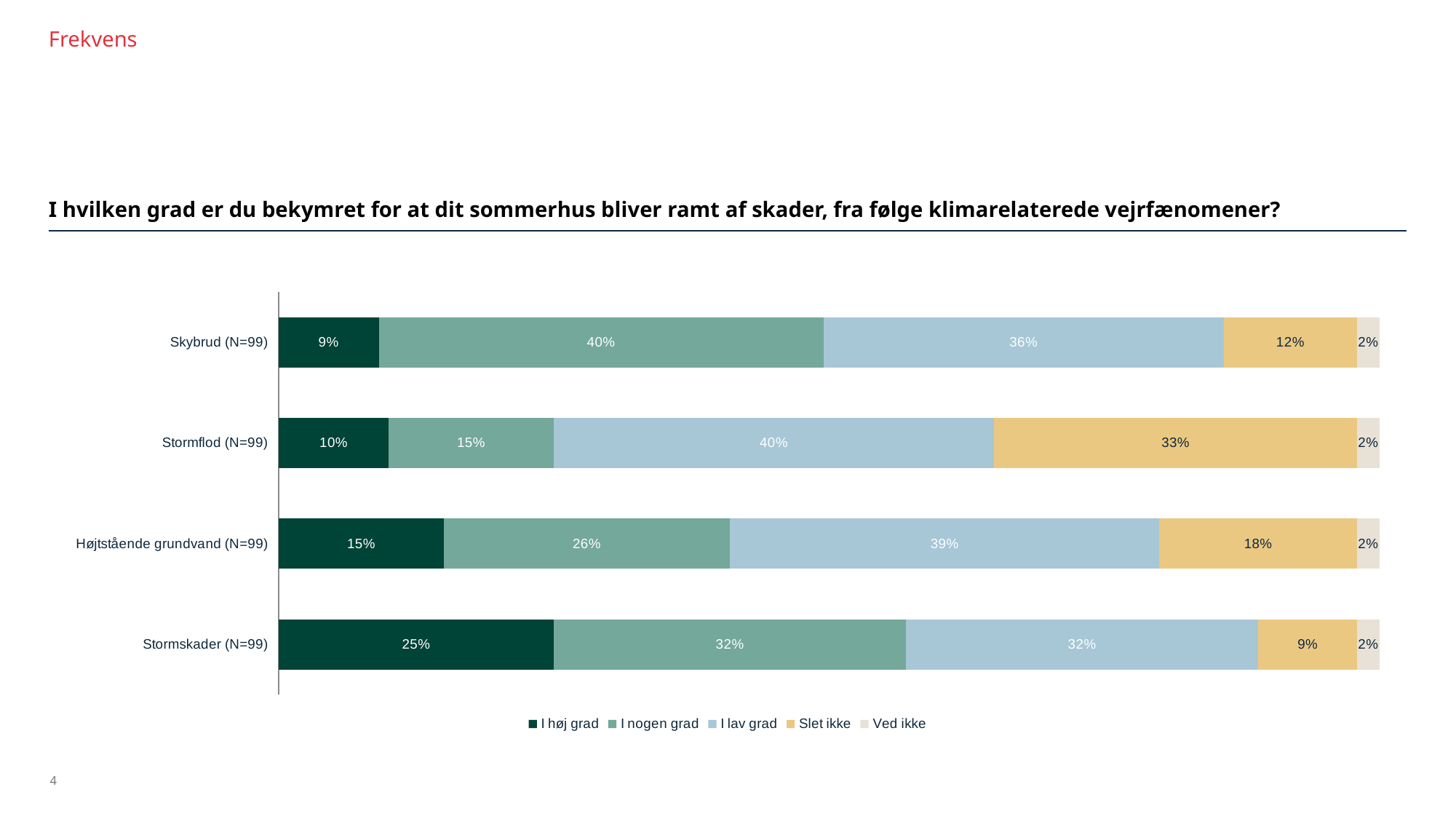
Which category has the lowest "I nogen grad" share? Stormflod (N=99) What is the combined share of "I høj grad" and "I nogen grad" for Stormskader (N=99)? 57% What is the difference between the "Slet ikke" values for Stormflod (N=99) and Skybrud (N=99)? 21 percentage points Which category has the highest "I høj grad" share? Stormskader (N=99) What kind of chart is shown on the slide? Stacked bar chart What percentage of respondents answered "I høj grad" for Stormskader (N=99)? 25% What is the "I nogen grad" value for Skybrud (N=99)? 40% Which is larger: the "I høj grad" value for Højtstående grundvand (N=99) or for Stormflod (N=99)? Højtstående grundvand (N=99) How many categories (weather phenomena) are shown in the chart? 4 What is the "Slet ikke" value for Stormflod (N=99)? 33% What is the "I lav grad" value for Højtstående grundvand (N=99)? 39% How many series does the legend list? 5